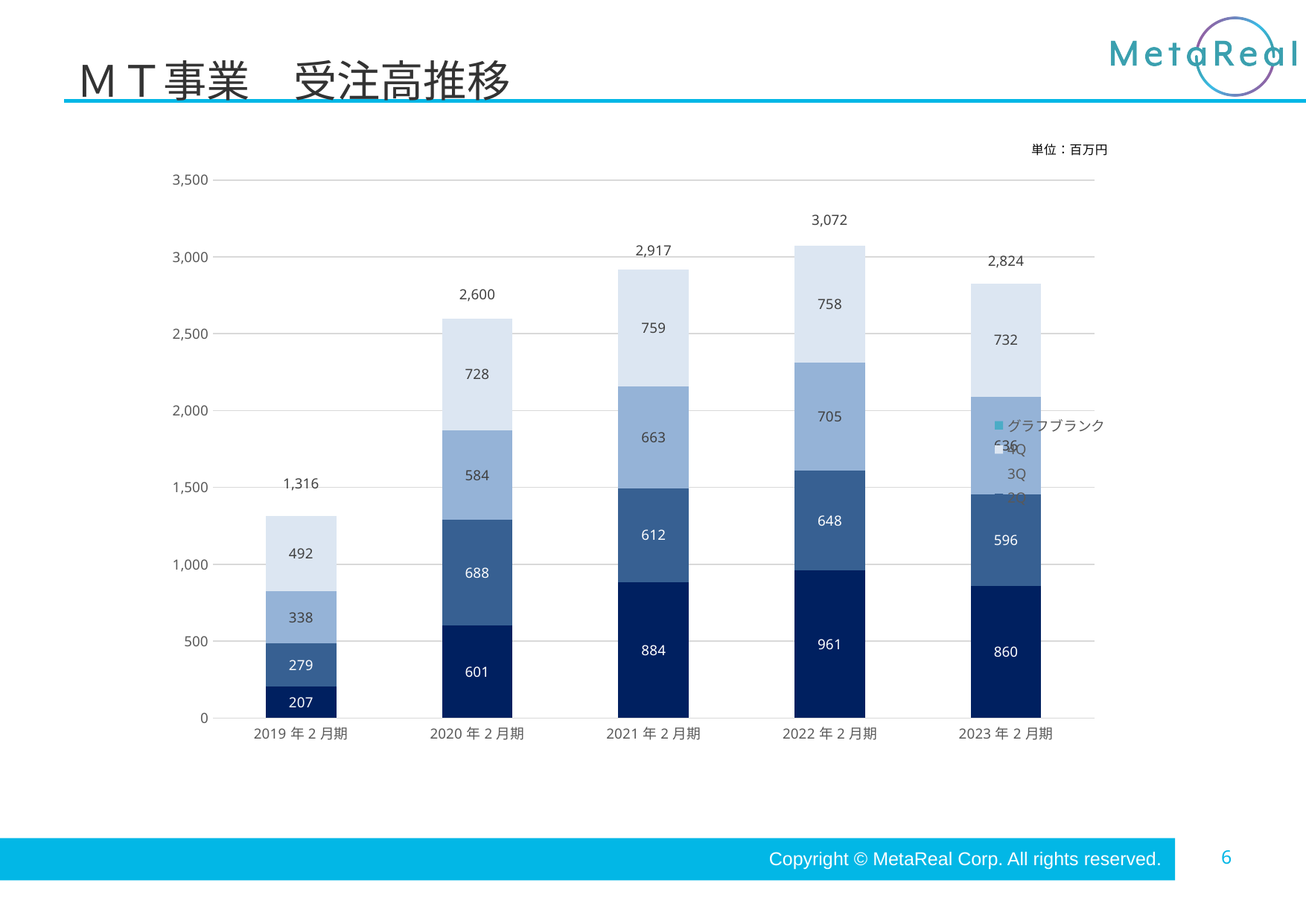
Which is larger, the total for 2020年2月期 or the total for 2021年2月期? 2021年2月期 What is the total of the stacked bar for 2019年2月期? 1,316 What is the total order intake shown above the bar for 2022年2月期? 3,072 What kind of chart is shown on the slide? Stacked bar chart What unit is stated for the values in the chart? 百万円 What is the value of the top (lightest) segment of the bar for 2020年2月期? 728 What is the difference between the total for 2022年2月期 and the total for 2023年2月期? 248 How many fiscal periods are shown on the x axis? 5 What is the value of the bottom (darkest) segment of the bar for 2021年2月期? 884 Which fiscal period has the lowest total order intake? 2019年2月期 Do the total order intake values rise or fall from 2019年2月期 to 2022年2月期? Rise Which fiscal period has the highest total order intake? 2022年2月期